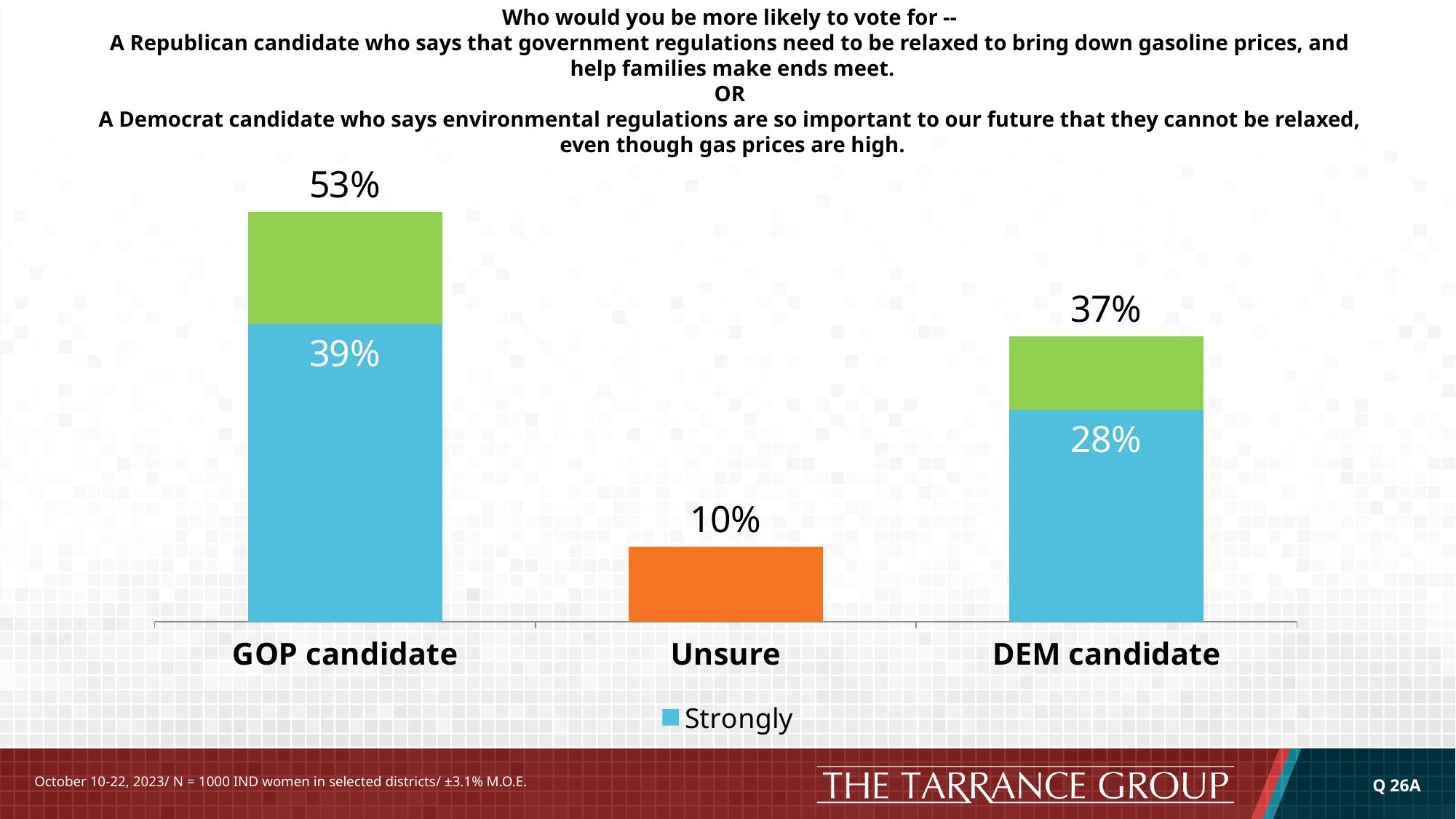
Which is larger, the 'Strongly' value for the GOP candidate or the total for the DEM candidate? GOP candidate 'Strongly' (39%) What is the total value shown for the DEM candidate bar? 37% What is the difference between the GOP candidate total and the DEM candidate total? 16% What is the 'Strongly' value for the GOP candidate? 39% How many categories are shown on the x axis? 3 What is the total value shown for the GOP candidate bar? 53% What kind of chart is shown on the slide? Bar chart Which category has the highest total value? GOP candidate Which category has the lowest value? Unsure What is the 'Strongly' value for the DEM candidate? 28% What is the difference between the 'Strongly' values for the GOP candidate and the DEM candidate? 11% What is the value shown for Unsure? 10%